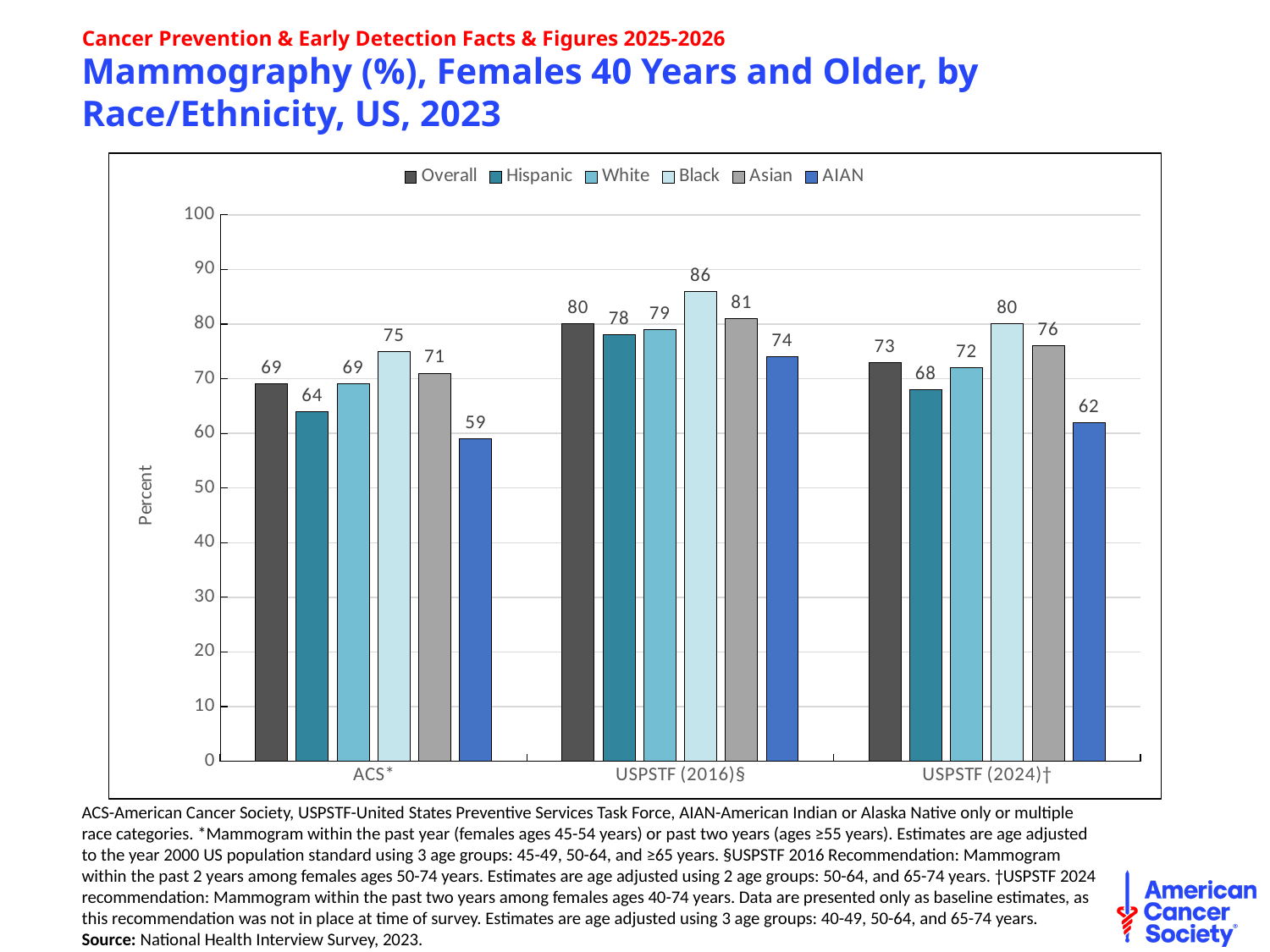
How many series does the legend list? 6 What is the value for Black females in the USPSTF (2016)§ group? 86 Is the AIAN value in the USPSTF (2016)§ group greater or less than 70? greater Which race/ethnicity series has the lowest value in the ACS* group? AIAN What is the value for AIAN females in the ACS* group? 59 What kind of chart is shown on the slide? Bar chart How many category groups are shown on the x axis? 3 Which race/ethnicity series has the highest value in the USPSTF (2016)§ group? Black What is the label of the y axis? Percent Which is larger: the Asian value in the ACS* group or the Asian value in the USPSTF (2024)† group? USPSTF (2024)† What is the Overall value in the USPSTF (2024)† group? 73 What is the difference between the Black and Hispanic values in the USPSTF (2024)† group? 12